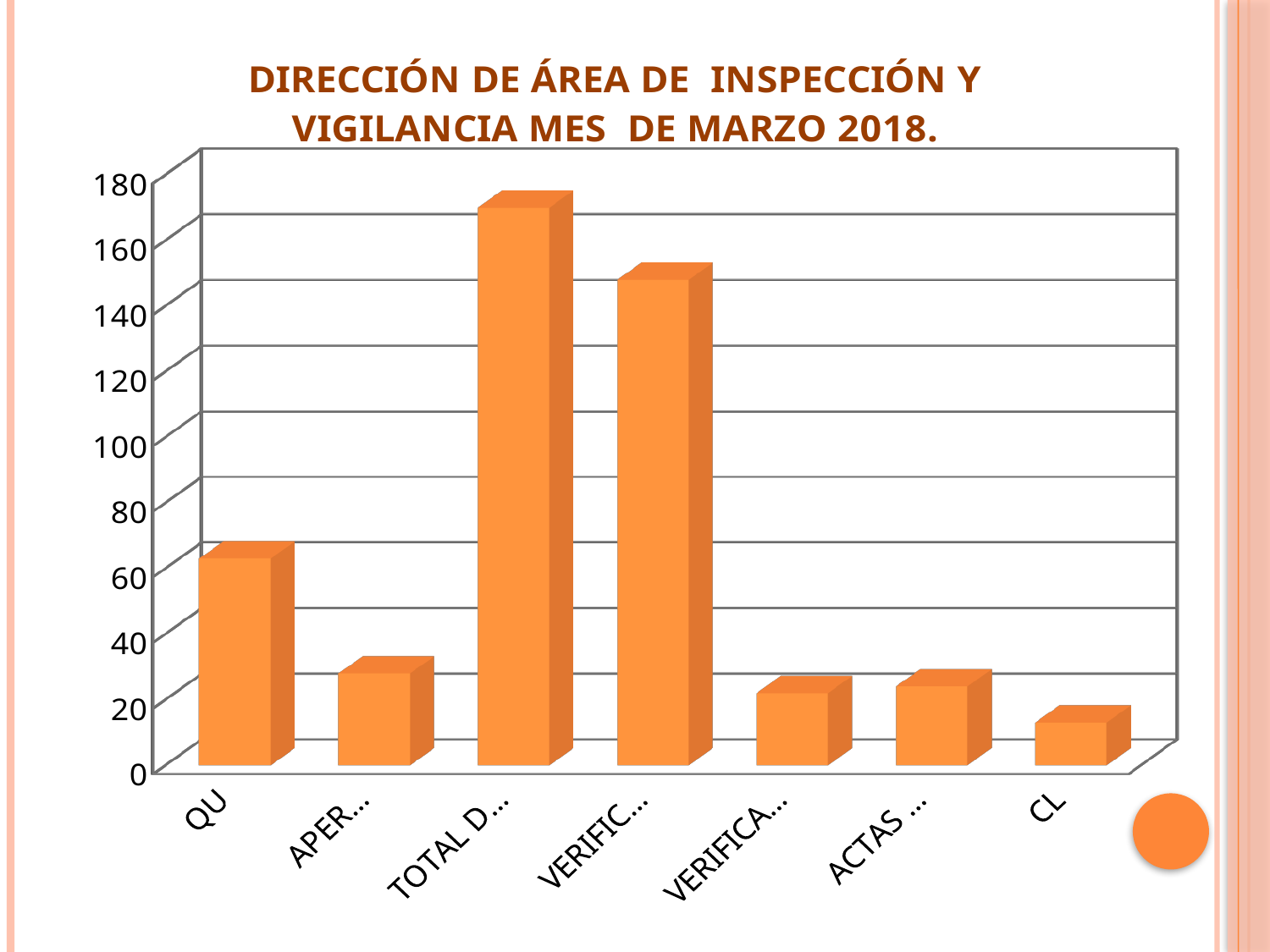
How many categories (bars) are plotted in the chart? 7 Which category has the lowest bar in the chart? CL What is the title of the chart? DIRECCIÓN DE ÁREA DE INSPECCIÓN Y VIGILANCIA MES DE MARZO 2018. Is the value for CL greater or less than 20? less Which category has the highest bar in the chart? TOTAL D... (the third bar) Is the value for QU greater or less than 80? less Which is larger, the value for QU or the value for the second bar (APER...)? QU Is the value for the fourth bar (VERIFIC...) greater or less than 140? greater What kind of chart is shown on the slide? Bar chart